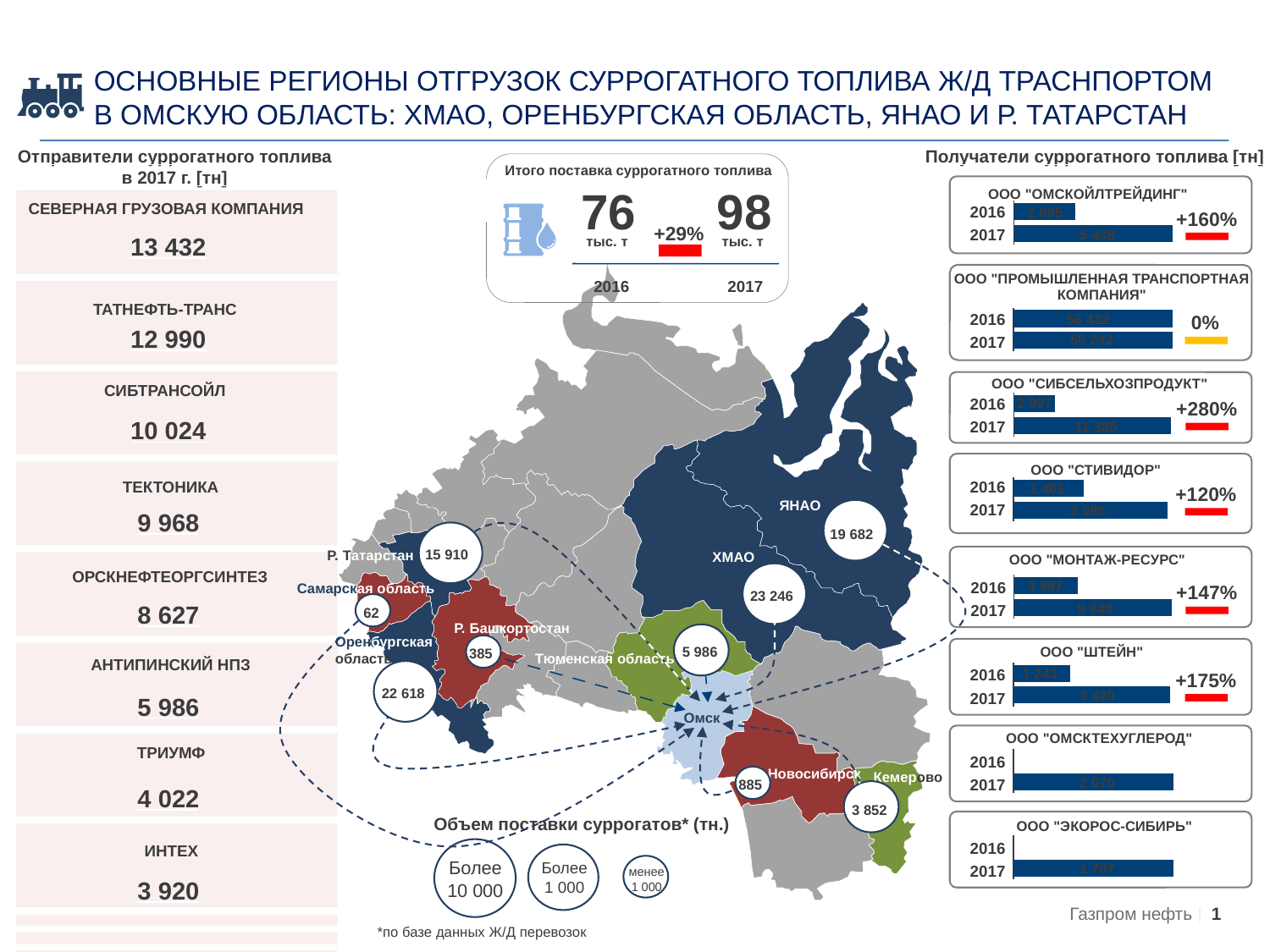
In the ООО "ОМСКОЙЛТРЕЙДИНГ" chart, what percentage change between 2016 and 2017 is shown? +160% How many years are plotted in the ООО "ШТЕЙН" chart? 2 In the ООО "ПРОМЫШЛЕННАЯ ТРАНСПОРТНАЯ КОМПАНИЯ" chart, what percentage change is shown? 0% In the "Итого поставка суррогатного топлива" box, what is the value for 2017? 98 тыс. т In the ООО "СИБСЕЛЬХОЗПРОДУКТ" chart, what percentage change is shown? +280% What kind of chart is used for each recipient company on the right side of the slide? bar chart In the ООО "ОМСКТЕХУГЛЕРОД" chart, which year has the larger value? 2017 On the map, what value is shown in the bubble for ХМАО? 23 246 In the ООО "СТИВИДОР" chart, which year has the longer bar, 2016 or 2017? 2017 In the "Итого поставка суррогатного топлива" box, what percentage change from 2016 to 2017 is shown? +29% In the ООО "ШТЕЙН" chart, what percentage change is shown? +175% Among the recipient charts on the right, which company shows the largest percentage growth? ООО "СИБСЕЛЬХОЗПРОДУКТ"